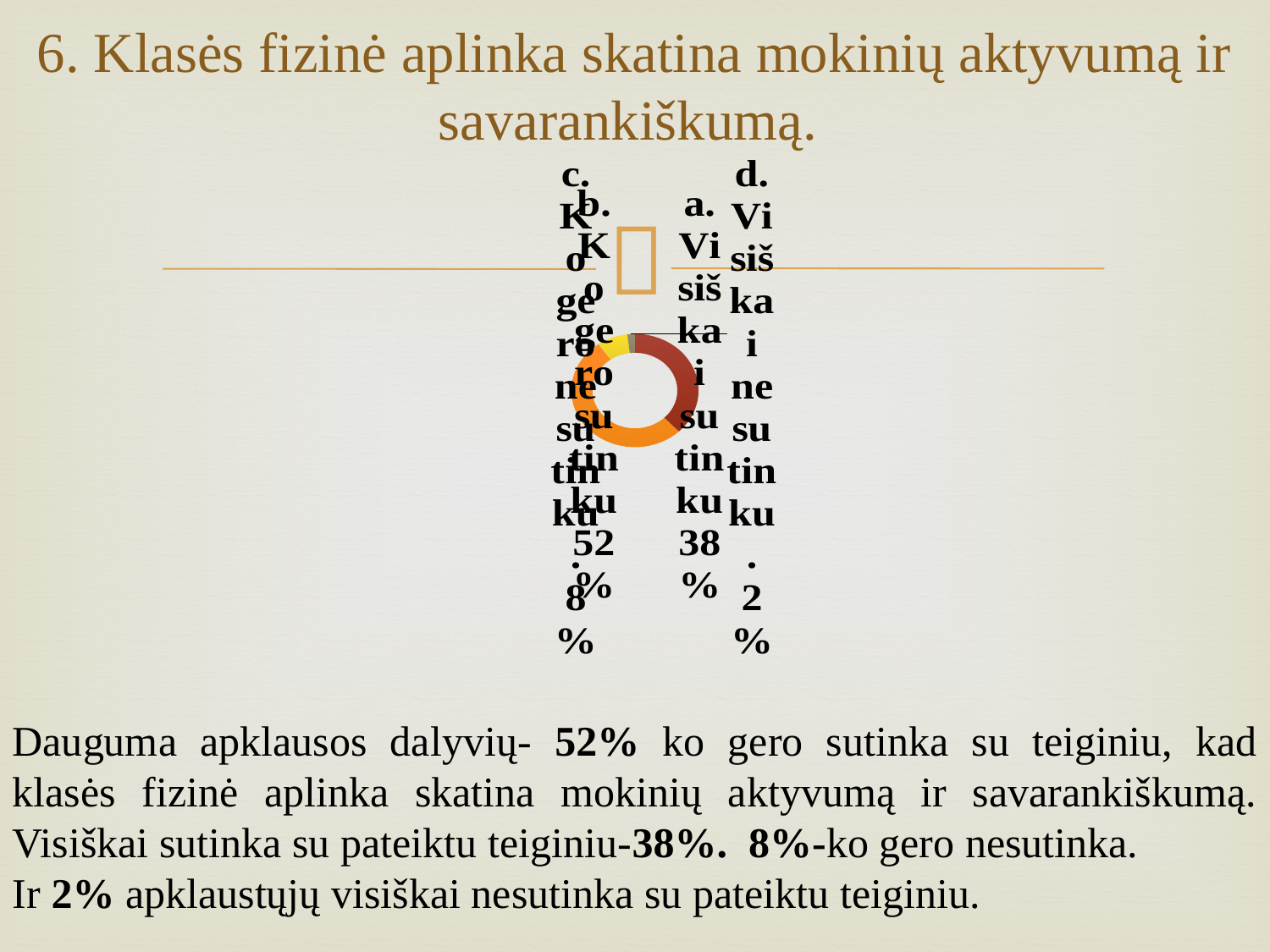
What percentage is shown for 'a. Visiškai sutinku'? 38% How many categories are shown in the chart? 4 What percentage is shown for 'c. Ko gero nesutinku'? 8% What is the difference between the shares for 'b. Ko gero sutinku' and 'a. Visiškai sutinku'? 14% What percentage is shown for 'b. Ko gero sutinku'? 52% Which category has the smallest share of the chart? d. Visiškai nesutinku What kind of chart is shown on the slide? doughnut (pie) chart What colour is the largest slice of the chart? orange Which is larger: the share for 'c. Ko gero nesutinku' or 'd. Visiškai nesutinku'? c. Ko gero nesutinku What percentage is shown for 'd. Visiškai nesutinku'? 2% Which category has the largest share of the chart? b. Ko gero sutinku What is the combined share of 'c. Ko gero nesutinku' and 'd. Visiškai nesutinku'? 10%